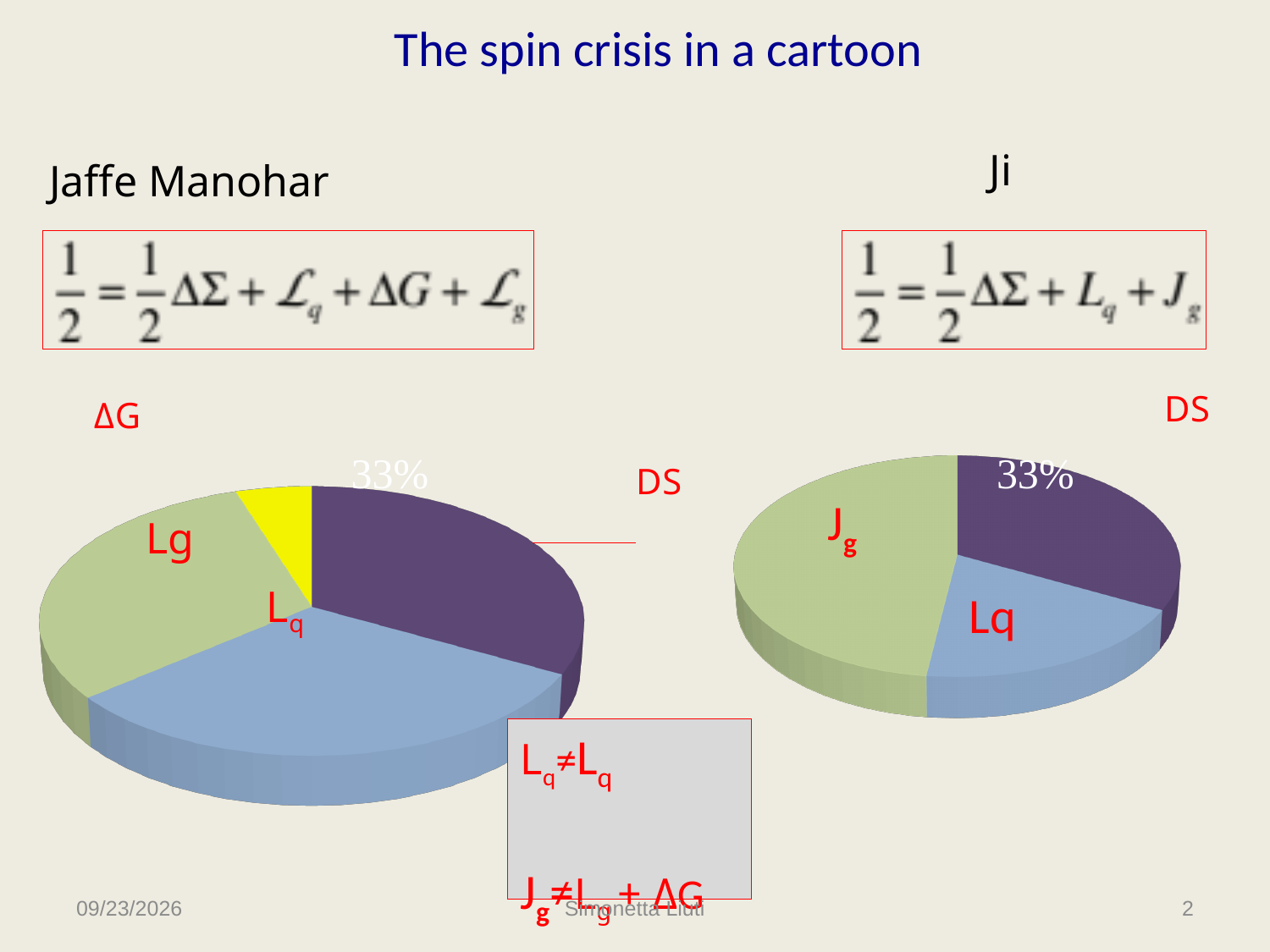
In the left pie chart (Jaffe Manohar), what share of the pie is the DS slice? 33% In the left pie chart (Jaffe Manohar), what colour is the ΔG slice? yellow What kind of chart is the right chart (Ji)? pie chart In the right pie chart (Ji), which slice is the largest? Jg How many slices does the left pie chart (Jaffe Manohar) have? 4 In the left pie chart (Jaffe Manohar), which slice is the smallest? ΔG In the right pie chart (Ji), which slice is larger, Jg or Lq? Jg In the right pie chart (Ji), what share of the pie is the DS slice? 33% In the left pie chart (Jaffe Manohar), which slice is larger, Lg or ΔG? Lg What kind of chart is the left chart (Jaffe Manohar)? pie chart Which slice label appears in the right pie chart (Ji) but not in the left pie chart (Jaffe Manohar)? Jg How many slices does the right pie chart (Ji) have? 3